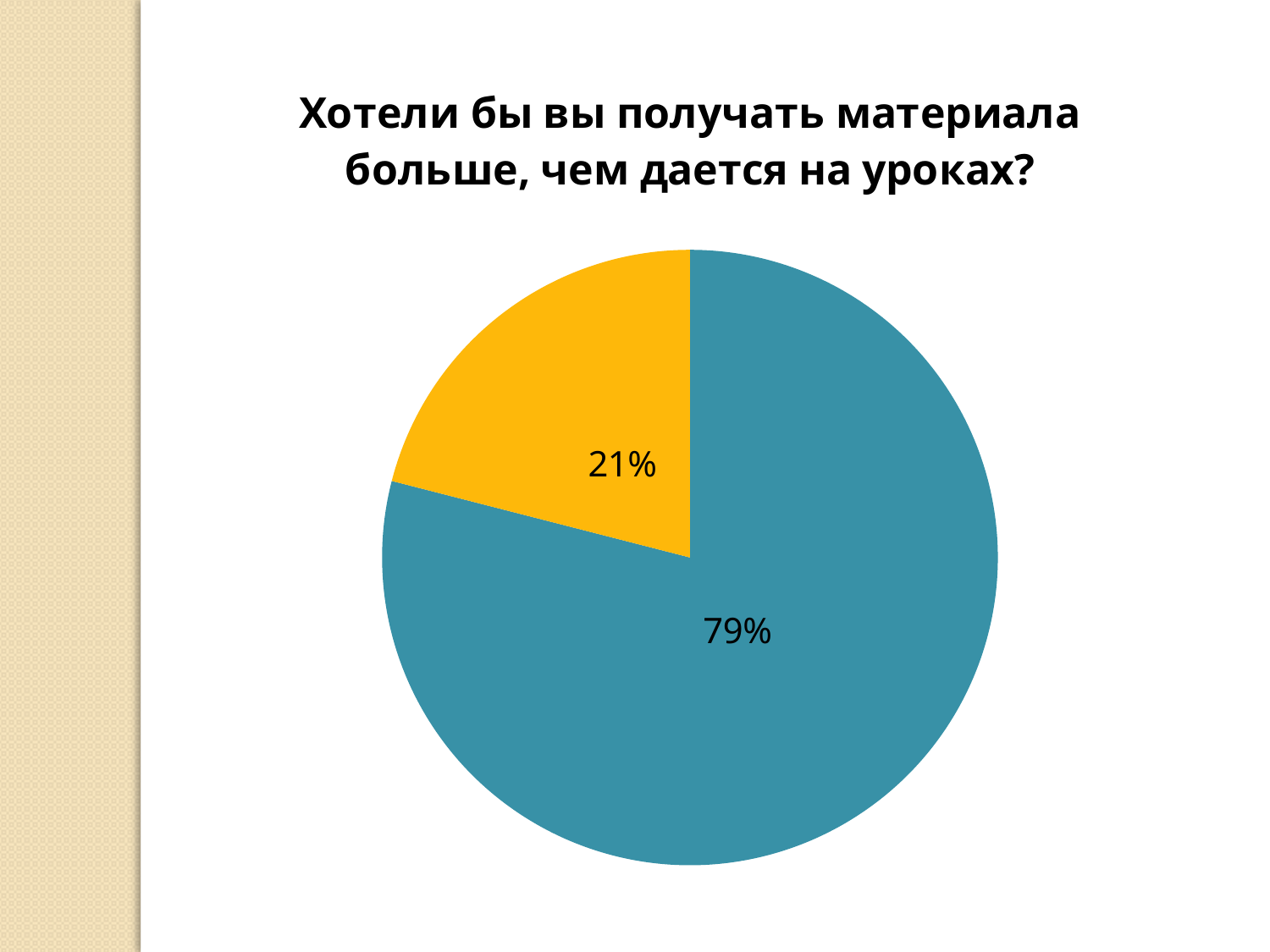
What is the title of the chart? Хотели бы вы получать материала больше, чем дается на уроках? What share of the pie does the yellow slice represent? 21% Which slice of the pie chart is the smallest? the yellow slice (21%) What kind of chart is shown on the slide? pie chart Is the value of the blue slice greater or less than 50%? greater What colour is the largest slice of the pie chart? blue Which is larger, the blue slice or the yellow slice? the blue slice What percentage is shown on the blue slice of the pie chart? 79% What is the difference in percentage points between the blue slice and the yellow slice? 58 Which slice of the pie chart is the largest? the blue slice (79%) How many slices does the pie chart have? 2 What percentage is shown on the yellow slice of the pie chart? 21%